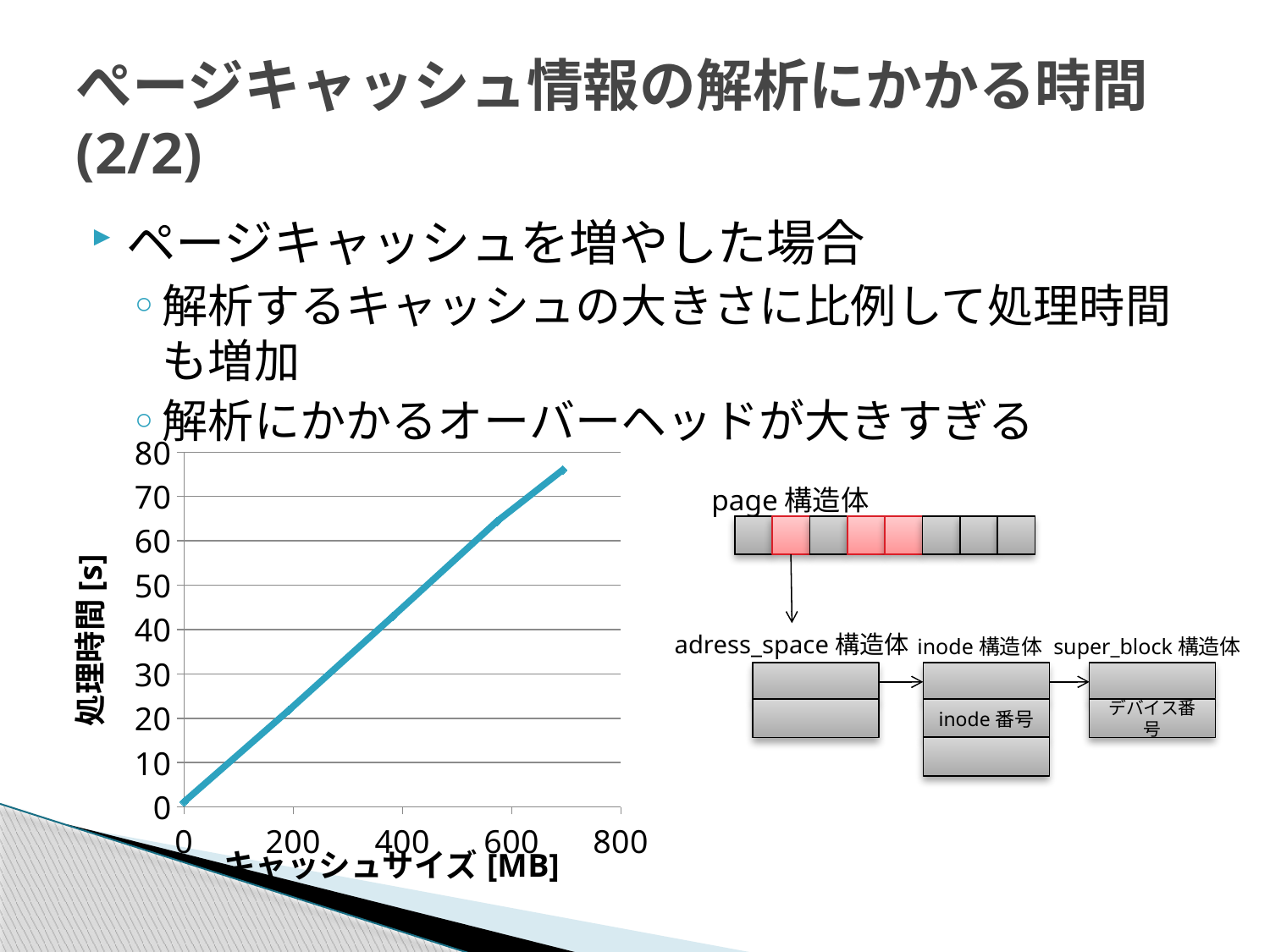
Is the processing time at a cache size of 400 MB greater or less than 50 s? less Is the processing time at a cache size of 600 MB greater or less than 70 s? less Is the processing time at a cache size of 400 MB greater or less than 30 s? greater What is the label of the x axis of the chart? キャッシュサイズ [MB] What is the label of the y axis of the chart? 処理時間 [s] Which has the larger processing time: a cache size of 200 MB or 600 MB? 600 MB What kind of chart is shown on the slide? line chart What is the highest value shown on the y axis of the chart? 80 Does the processing time (処理時間) rise or fall as the cache size (キャッシュサイズ) increases along the x axis? rise